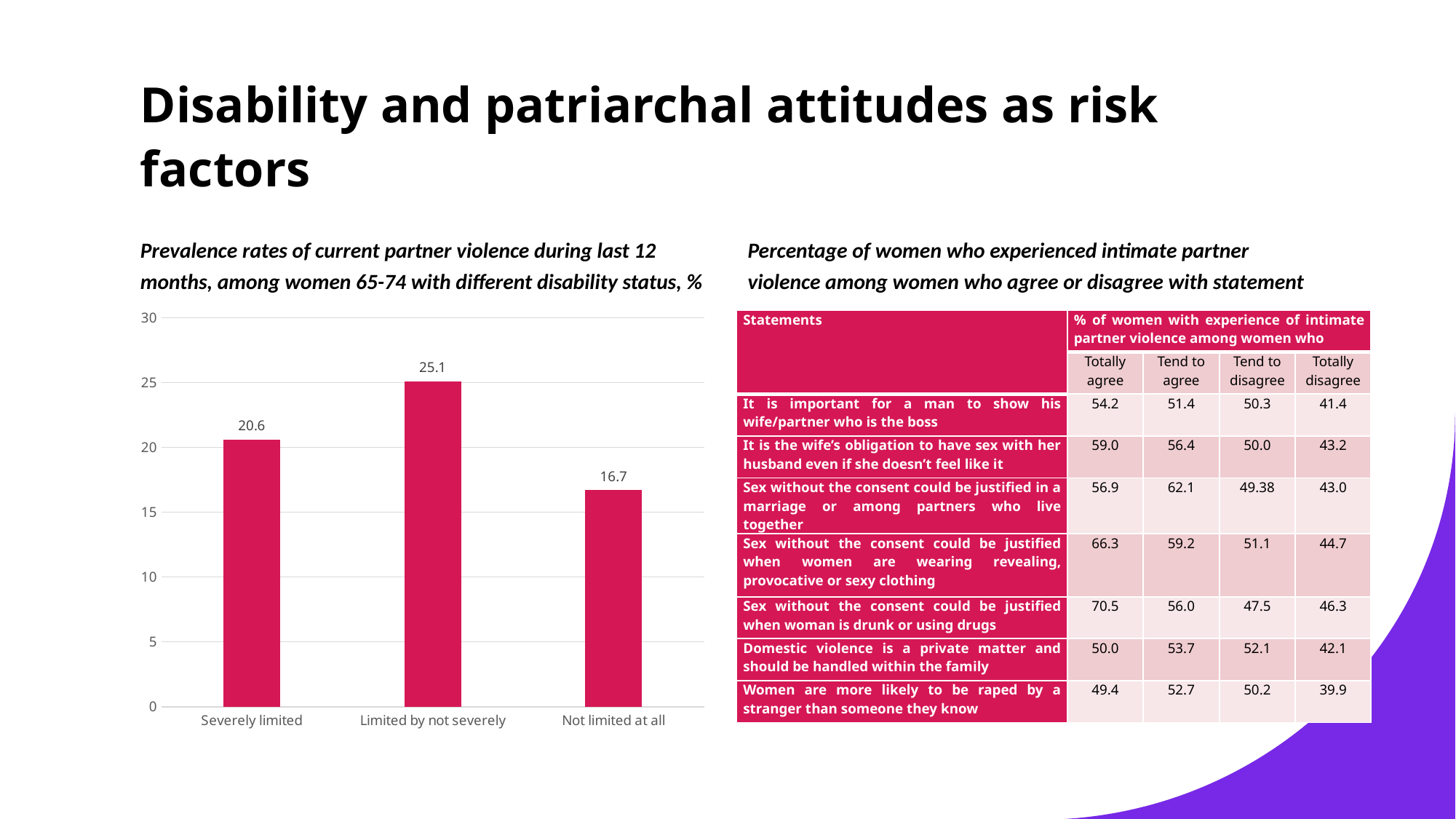
What type of chart is used to show prevalence rates by disability status? Bar chart What is the prevalence rate for women who are limited by not severely? 25.1 Which disability status category has the lowest prevalence rate? Not limited at all Is the value for 'Limited by not severely' greater or less than 25? greater Which is larger, the prevalence rate for 'Severely limited' or for 'Not limited at all'? Severely limited What is the prevalence rate for women who are not limited at all? 16.7 What is the maximum value shown on the vertical axis of the bar chart? 30 What is the difference between the prevalence rates for 'Limited by not severely' and 'Not limited at all'? 8.4 What is the prevalence rate for women who are severely limited? 20.6 How many disability status categories are shown in the bar chart? 3 What is the difference between the prevalence rates for 'Severely limited' and 'Not limited at all'? 3.9 Which disability status category has the highest prevalence rate? Limited by not severely